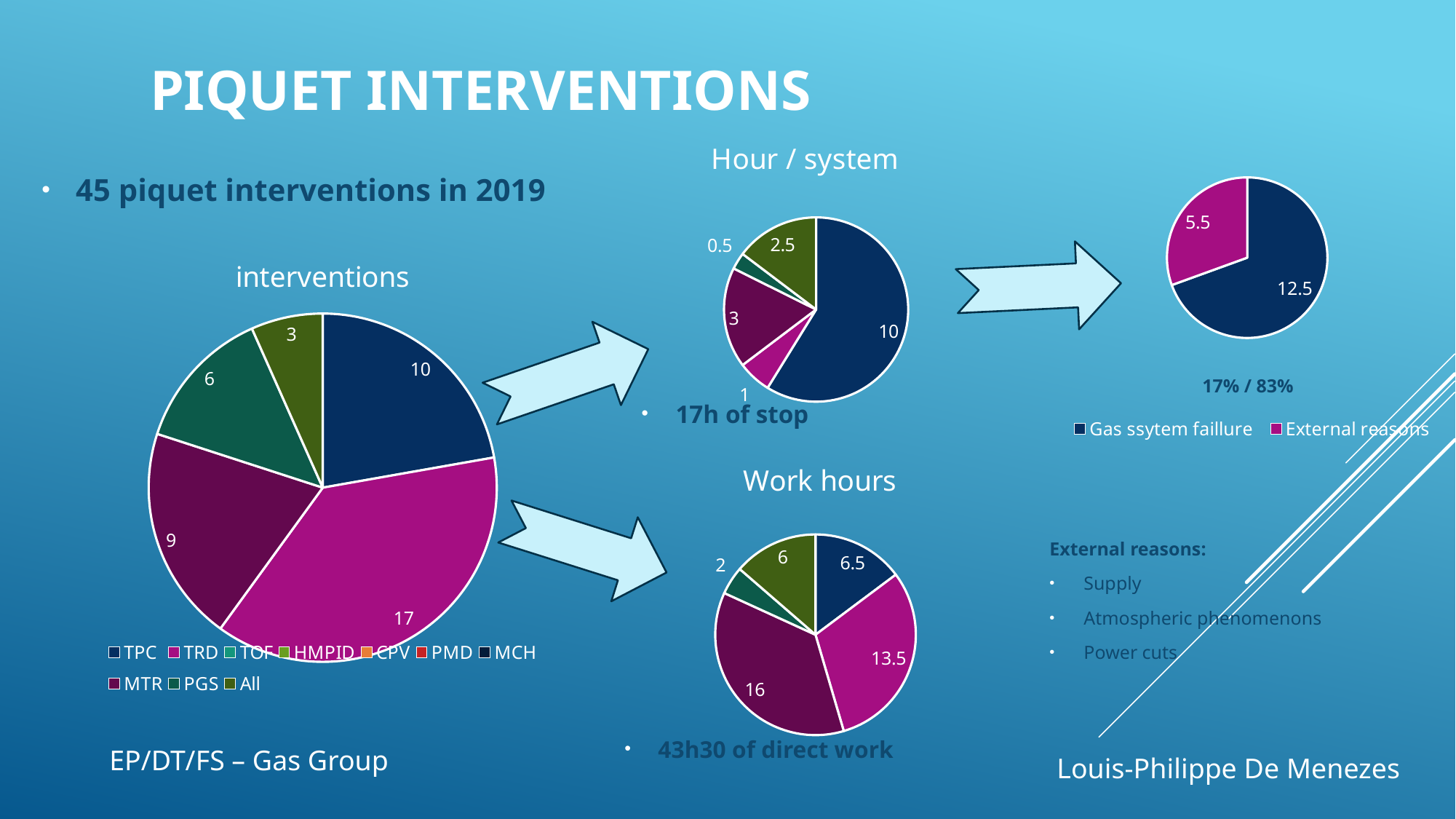
In the pie chart on the right of the slide, what is the value for External reasons? 5.5 In the "Hour / system" pie chart, what is the smallest value shown? 0.5 In the "Work hours" pie chart, what is the largest value shown? 16 What kind of chart is the "Hour / system" chart? pie chart In the "interventions" pie chart, what is the difference between the TRD and MTR values? 8 In the "Work hours" pie chart, what is the difference between the largest value and the value 13.5? 2.5 How many entries does the legend of the "interventions" pie chart list? 10 In the "interventions" pie chart, which category has the largest slice? TRD In the "interventions" pie chart, what is the value for TRD? 17 In the "Hour / system" pie chart, what is the largest value shown? 10 In the "interventions" pie chart, what is the value for TPC? 10 In the "interventions" pie chart, which is larger, the value for PGS or the value for All? PGS